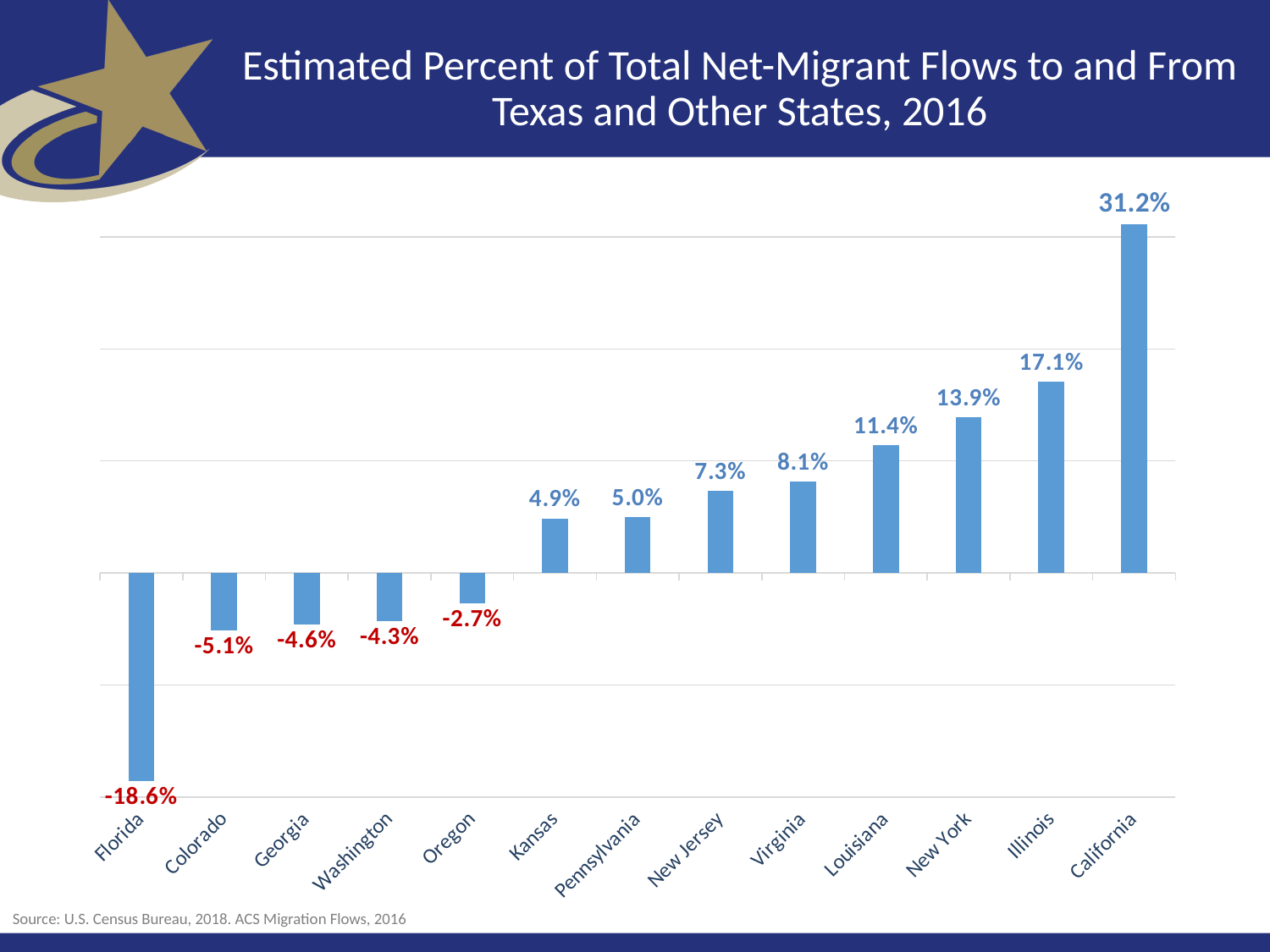
What is the difference between the values for California and Illinois? 14.1 percentage points Which state has the lowest value? Florida What is the value for Florida? -18.6% What kind of chart is this? Bar chart Which state has the highest value? California What is the value for Oregon? -2.7% Do the values rise or fall from left to right along the x axis? Rise What is the title of the chart? Estimated Percent of Total Net-Migrant Flows to and From Texas and Other States, 2016 What is the value for California? 31.2% How many states are shown on the chart? 13 What is the value for Louisiana? 11.4% Which has the larger value, New York or Virginia? New York